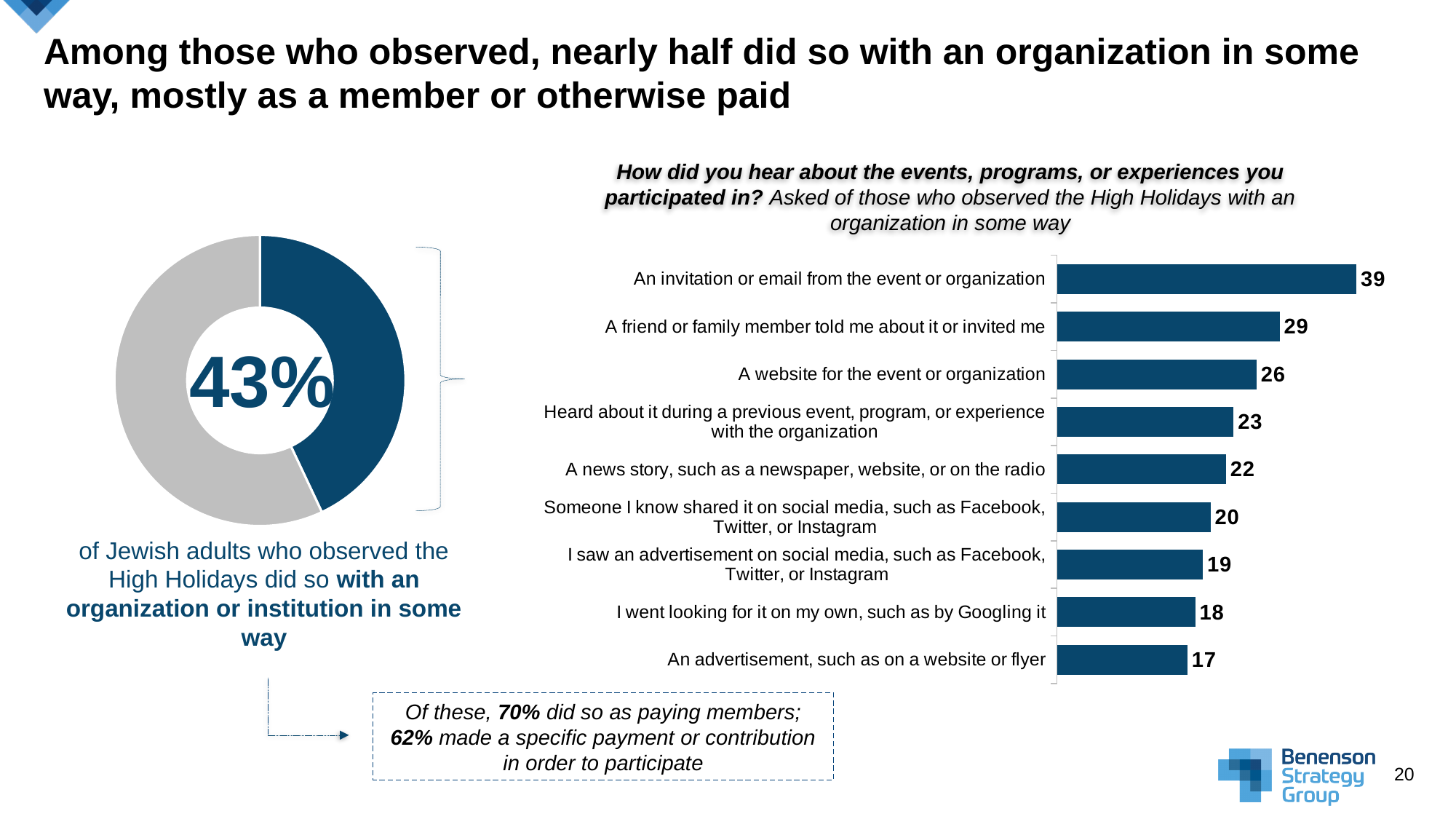
In the bar chart on the right, which category has the highest value? An invitation or email from the event or organization How many categories are shown in the bar chart on the right? 9 In the bar chart on the right, what is the value for "A website for the event or organization"? 26 In the bar chart on the right, which category has the lowest value? An advertisement, such as on a website or flyer In the bar chart on the right, what is the value for "I went looking for it on my own, such as by Googling it"? 18 In the bar chart on the right, do the values rise or fall going from the top category to the bottom category? Fall In the bar chart on the right, what is the difference between the values for "An invitation or email from the event or organization" and "A friend or family member told me about it or invited me"? 10 What kind of chart is on the right side of the slide? Bar chart In the bar chart on the right, which is larger: the value for "A news story, such as a newspaper, website, or on the radio" or the value for "Someone I know shared it on social media, such as Facebook, Twitter, or Instagram"? A news story, such as a newspaper, website, or on the radio What kind of chart is on the left side of the slide? Doughnut chart In the bar chart on the right, what is the value for "An invitation or email from the event or organization"? 39 In the doughnut chart on the left, what share of Jewish adults who observed the High Holidays did so with an organization or institution in some way? 43%